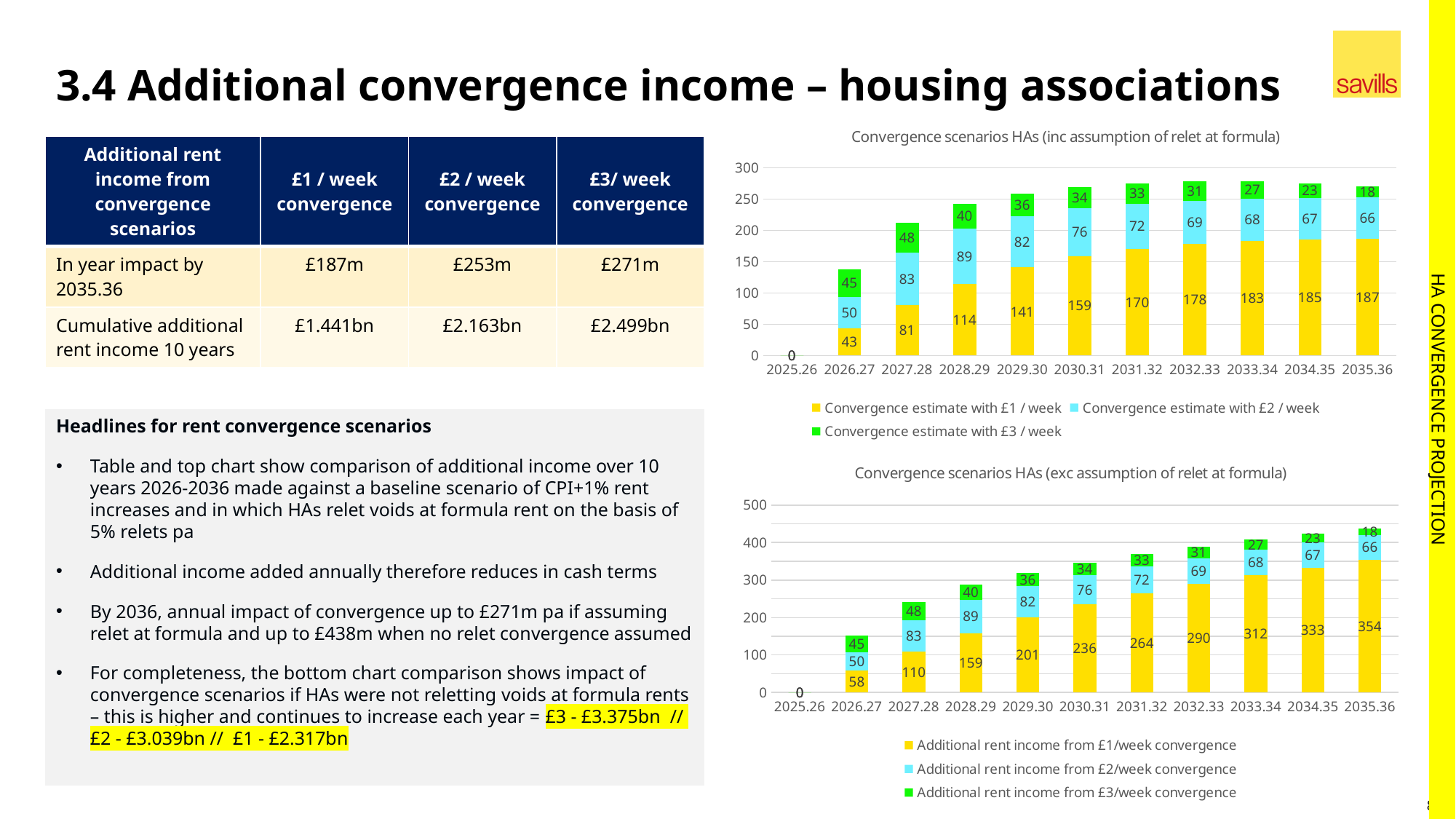
How many years are shown on the x axis of the top chart (inc assumption of relet at formula)? 11 In the bottom chart (exc assumption of relet at formula), what is the additional rent income from £1/week convergence for 2033.34? 312 In the top chart (inc assumption of relet at formula), which year has the highest £2 / week convergence estimate? 2028.29 In the top chart (inc assumption of relet at formula), what is the total of the stacked bar for 2035.36? 271 What type of chart is the top chart, 'Convergence scenarios HAs (inc assumption of relet at formula)'? Stacked bar chart In the bottom chart (exc assumption of relet at formula), which is larger: the £1/week convergence value for 2029.30 or the £1/week value for 2030.31? 2030.31 In the top chart (inc assumption of relet at formula), what is the value of the £3 / week convergence estimate for 2027.28? 48 How many series does the legend of the bottom chart (exc assumption of relet at formula) list? 3 In the bottom chart (exc assumption of relet at formula), what is the total of the stacked bar for 2035.36? 438 In the top chart (inc assumption of relet at formula), what is the value of the £1 / week convergence estimate for 2035.36? 187 In the top chart (inc assumption of relet at formula), does the £3 / week convergence estimate rise or fall from 2027.28 to 2035.36? Fall In the bottom chart (exc assumption of relet at formula), what is the difference between the £1/week convergence values for 2035.36 and 2034.35? 21